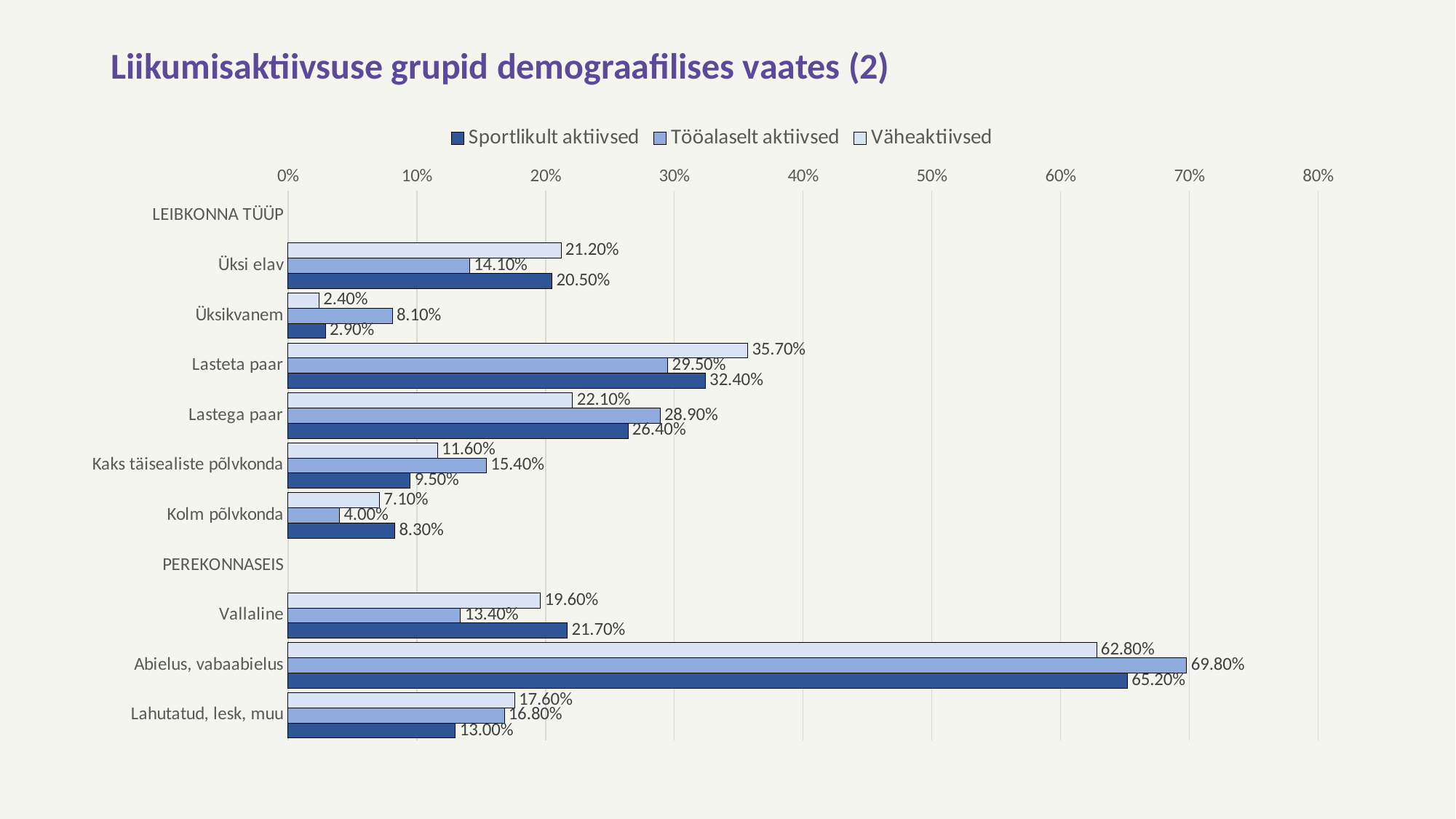
What is the value for Väheaktiivsed in the Lasteta paar category? 35.70% How many series does the legend list? 3 Which category has the lowest value for Väheaktiivsed? Üksikvanem Which category has the highest value for Tööalaselt aktiivsed? Abielus, vabaabielus Which is larger for Lastega paar: the Tööalaselt aktiivsed value or the Väheaktiivsed value? Tööalaselt aktiivsed What is the difference between the Tööalaselt aktiivsed and Sportlikult aktiivsed values for Abielus, vabaabielus? 4.60% What is the title of the chart on the slide? Liikumisaktiivsuse grupid demograafilises vaates (2) What is the difference between the Väheaktiivsed and Tööalaselt aktiivsed values for Kolm põlvkonda? 3.10% What is the value for Tööalaselt aktiivsed in the Üksikvanem category? 8.10% What kind of chart is shown on the slide? bar chart What is the value for Sportlikult aktiivsed in the Vallaline category? 21.70% Is the Sportlikult aktiivsed value for Lasteta paar greater or less than 30%? greater